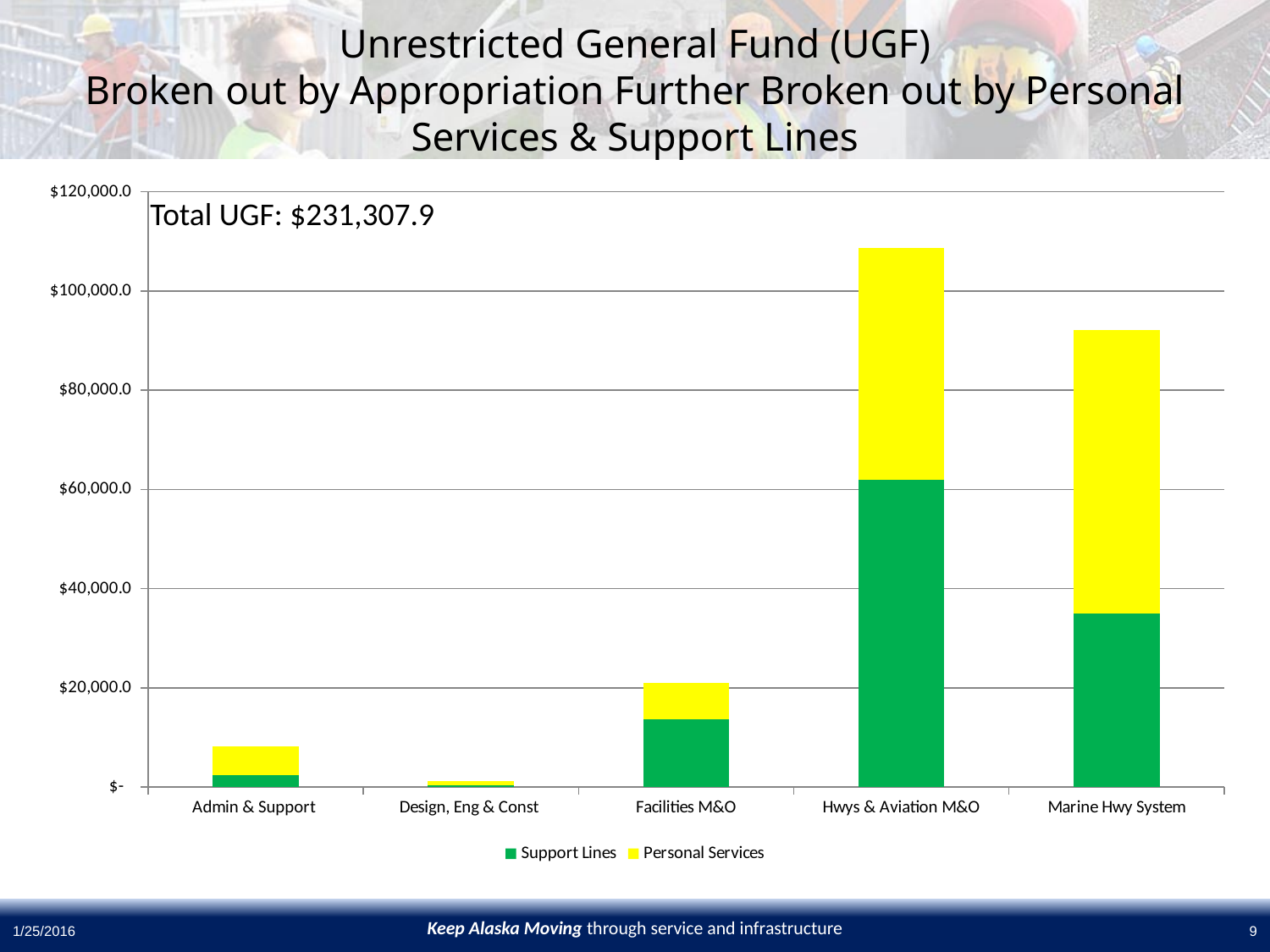
What Total UGF amount is printed on the chart? $231,307.9 Which appropriation has the shortest stacked bar? Design, Eng & Const Is the total bar for Marine Hwy System greater or less than $100,000.0? less Is the Support Lines value for Facilities M&O greater or less than $20,000.0? less What kind of chart is shown on the slide? Stacked bar chart Which appropriation has the tallest stacked bar? Hwys & Aviation M&O Which has a taller total bar, Marine Hwy System or Facilities M&O? Marine Hwy System Which colour represents Personal Services in the legend? Yellow Is the total bar for Hwys & Aviation M&O greater or less than $100,000.0? greater How many appropriation categories are shown on the x axis? 5 How many series does the legend list? 2